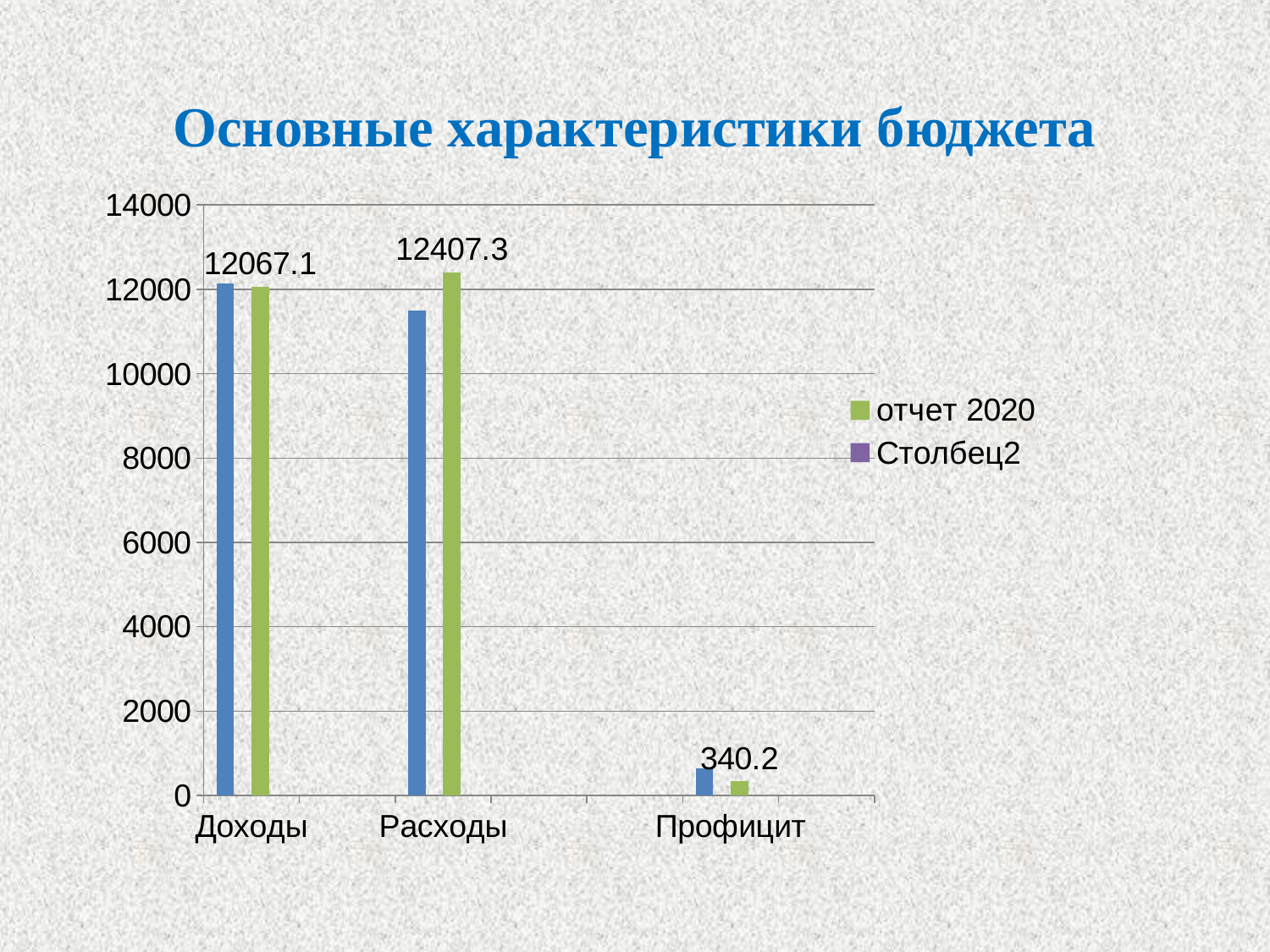
What is the difference between the отчет 2020 values for Расходы and Доходы? 340.2 What is the title of the chart? Основные характеристики бюджета What is the value of the отчет 2020 bar for Доходы? 12067.1 For the отчет 2020 series, which is larger: Доходы or Расходы? Расходы How many series does the legend list? 2 Which category has the lowest отчет 2020 value? Профицит Is the value of the blue bar for Расходы greater or less than 12000? less Is the value of the blue bar for Профицит greater or less than 2000? less How many categories are shown on the x axis? 3 What is the value of the отчет 2020 bar for Профицит? 340.2 What is the value of the отчет 2020 bar for Расходы? 12407.3 Which category has the highest отчет 2020 value? Расходы